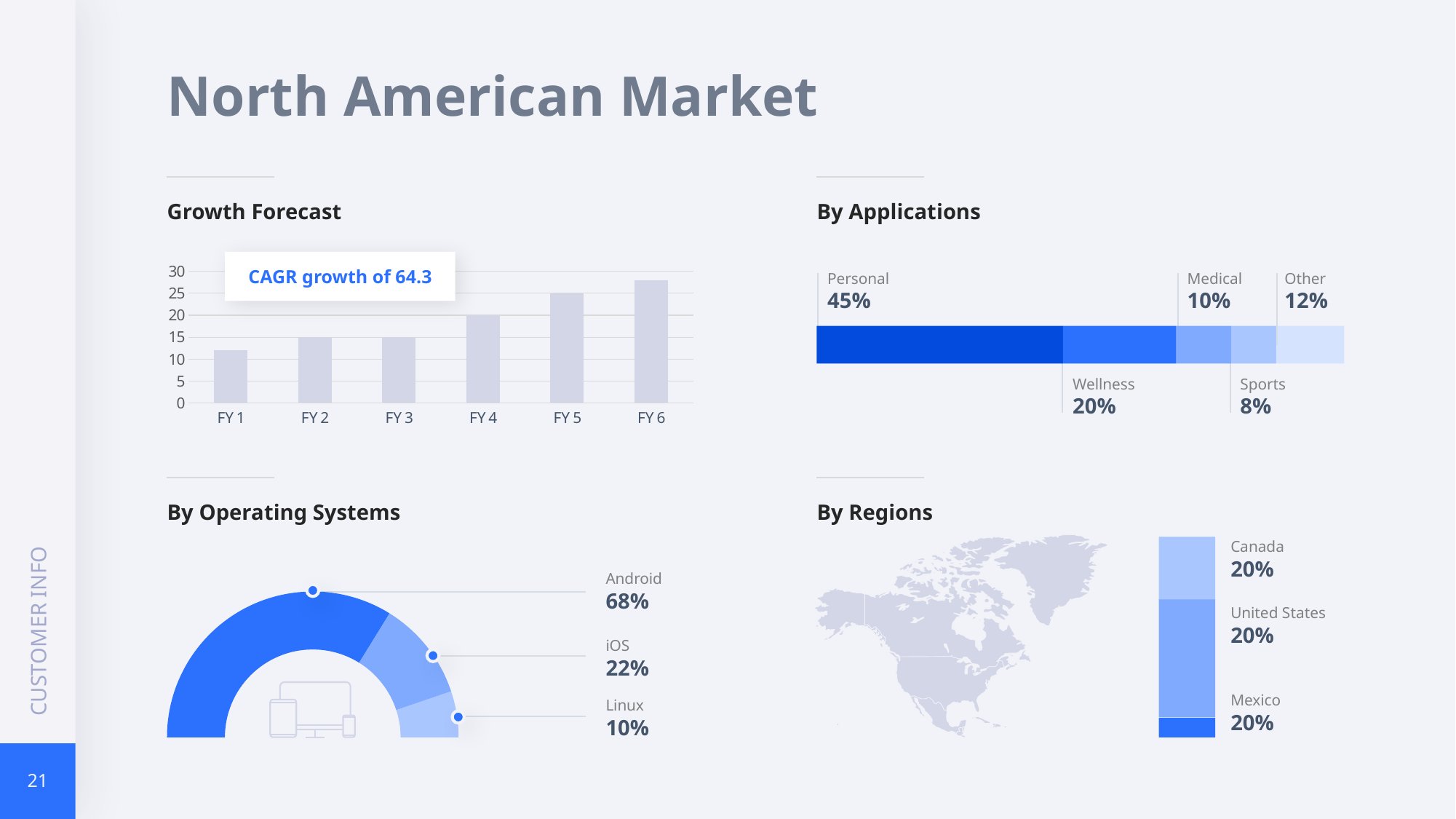
On the By Regions chart, what is the value for Mexico? 20% On the Growth Forecast chart, is the value for FY 1 greater or less than 15? less On the Growth Forecast chart, do the values rise or fall from FY 1 to FY 6? rise On the By Operating Systems chart, what is the share for Android? 68% What kind of chart is the Growth Forecast chart? bar chart On the Growth Forecast chart, which fiscal year has the highest bar? FY 6 How many fiscal years are shown on the Growth Forecast chart? 6 On the By Applications chart, what is the share for Personal? 45% On the Growth Forecast chart, what is the value for FY 4? 20 On the By Applications chart, what is the difference between the Personal and Wellness shares? 25% On the By Applications chart, which application has the smallest share? Sports On the By Applications chart, which is larger, Medical or Other? Other